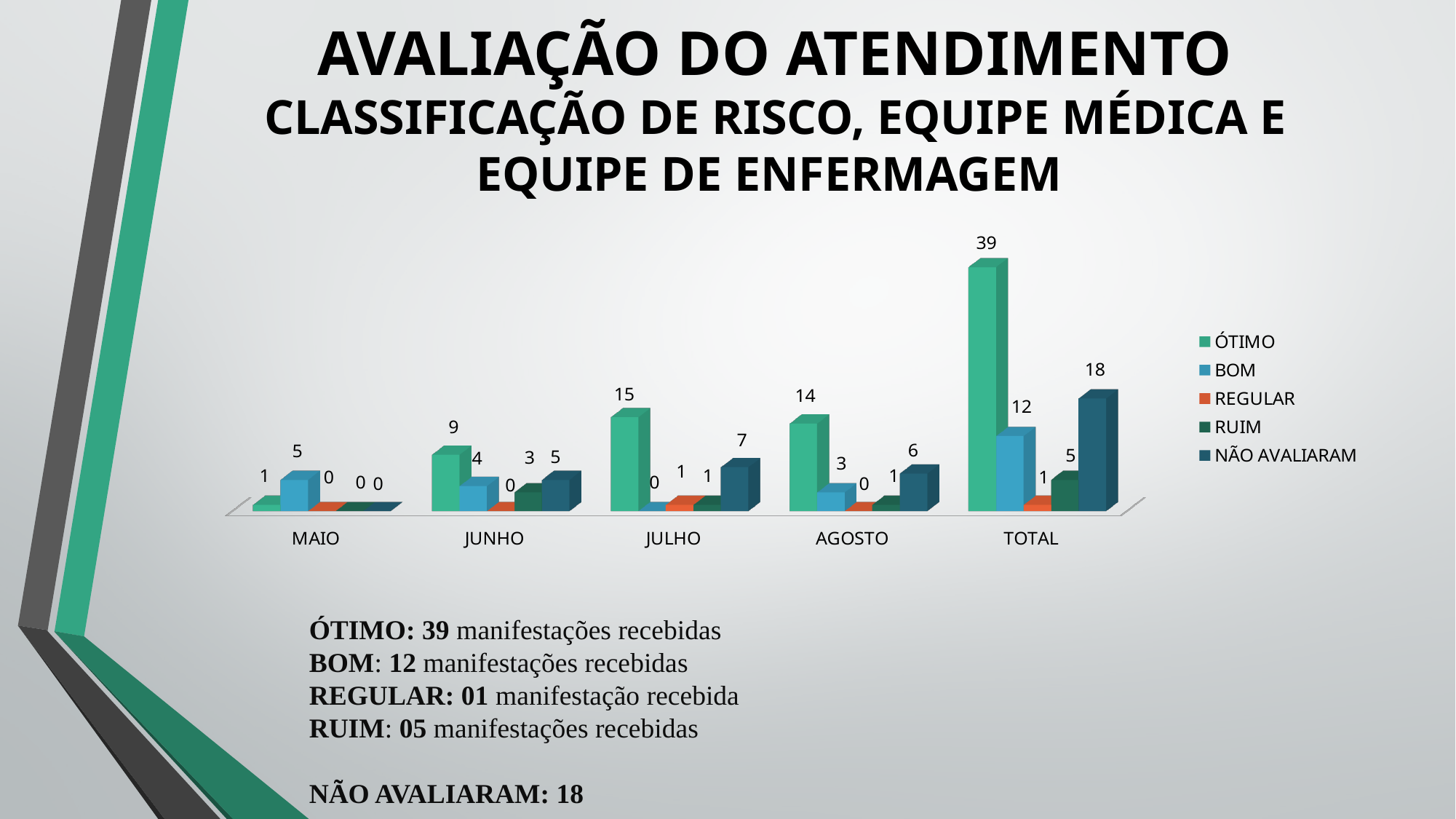
In which category is the ÓTIMO value highest? TOTAL Which is larger, the NÃO AVALIARAM value in JULHO or in AGOSTO? JULHO What kind of chart is shown on the slide? bar chart What is the value for ÓTIMO in JULHO? 15 How many categories are shown on the x axis? 5 What is the value for NÃO AVALIARAM in TOTAL? 18 What is the value for BOM in MAIO? 5 How many series does the legend list? 5 Among the months MAIO, JUNHO, JULHO and AGOSTO, which has the lowest ÓTIMO value? MAIO Which series is shown in orange in the legend? REGULAR What is the value for RUIM in JUNHO? 3 What is the difference between the ÓTIMO value in JULHO and the ÓTIMO value in AGOSTO? 1